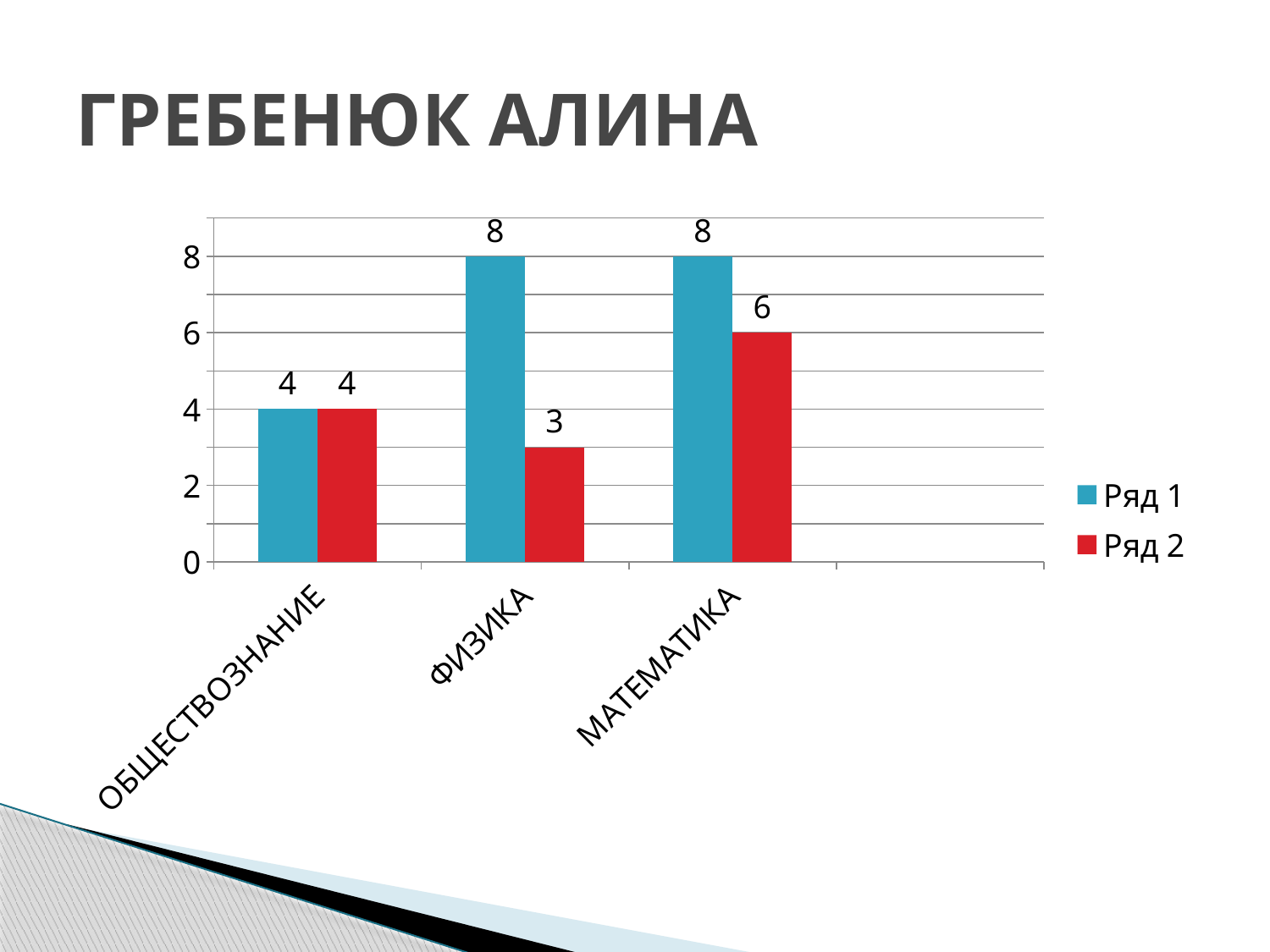
What is the value of Ряд 1 for ФИЗИКА? 8 What is the value of Ряд 1 for ОБЩЕСТВОЗНАНИЕ? 4 What is the difference between Ряд 1 and Ряд 2 for ФИЗИКА? 5 Which category has the lowest value for Ряд 2? ФИЗИКА What is the value of Ряд 2 for ФИЗИКА? 3 How many categories are shown on the x axis? 3 What is the value of Ряд 2 for МАТЕМАТИКА? 6 What is the title of the slide? ГРЕБЕНЮК АЛИНА What kind of chart is shown on the slide? Bar chart Which is larger for МАТЕМАТИКА, Ряд 1 or Ряд 2? Ряд 1 Which category has the highest value for Ряд 2? МАТЕМАТИКА How many series does the legend list? 2